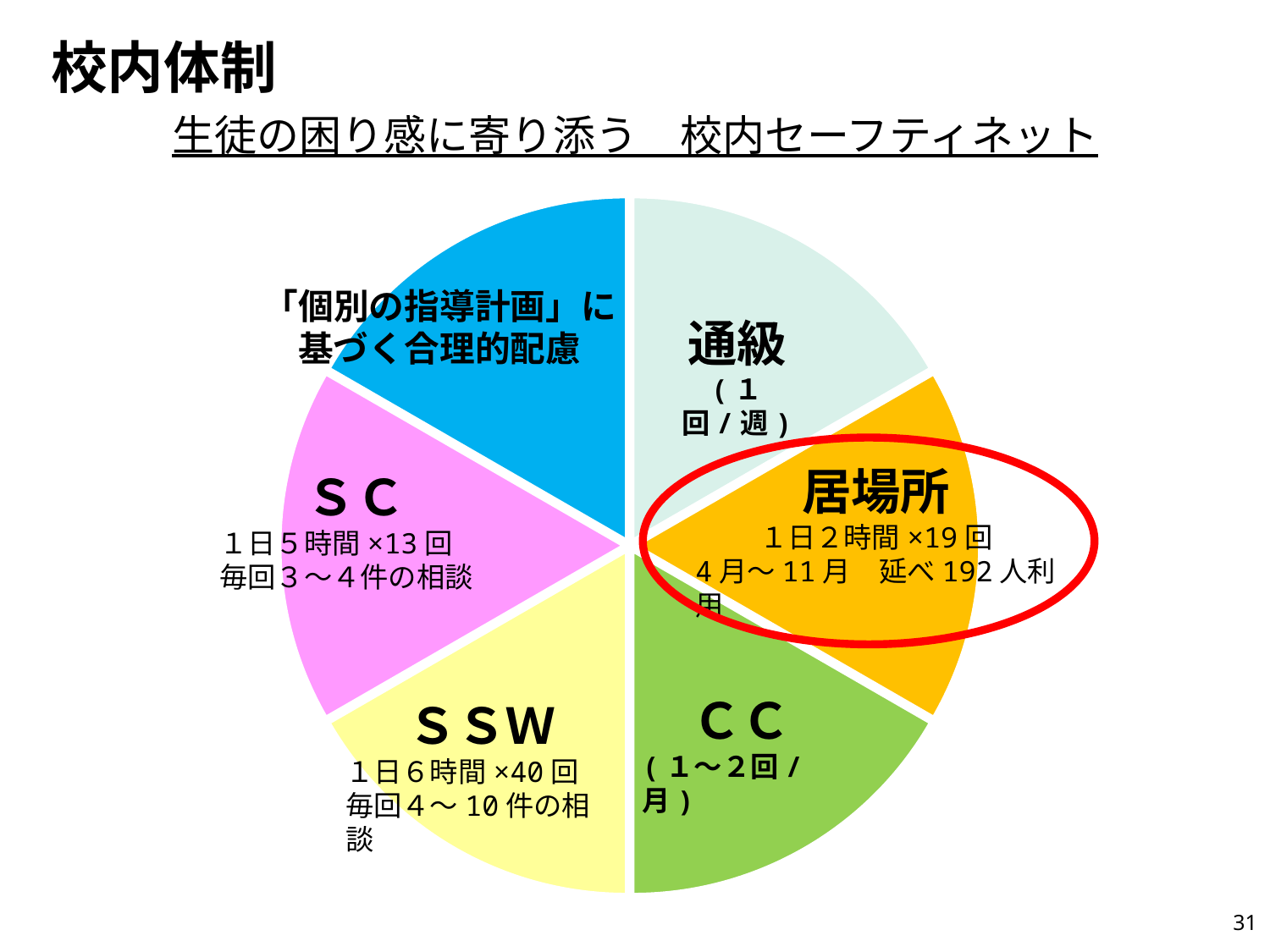
Which slice of the pie chart is circled in red? 居場所 According to the 居場所 slice label, how many people in total used it from April to November? 延べ192人 How many slices does the pie chart have? 6 How often is CC held according to its slice label? 1〜2回/月 What colour is the 居場所 slice of the pie chart? orange According to the SC slice label, how many hours per day and how many sessions are listed? 1日5時間×13回 According to the SC slice label, how many consultations are there each time? 3〜4件 What kind of chart is shown on the slide? pie chart According to the SSW slice label, how many hours per day and how many sessions are listed? 1日6時間×40回 According to the label on the 居場所 slice, how many times was it held (1日2時間×?)? 19回 How often is 通級 held according to its slice label? 1回/週 According to the SSW slice label, how many consultations are there each time? 4〜10件